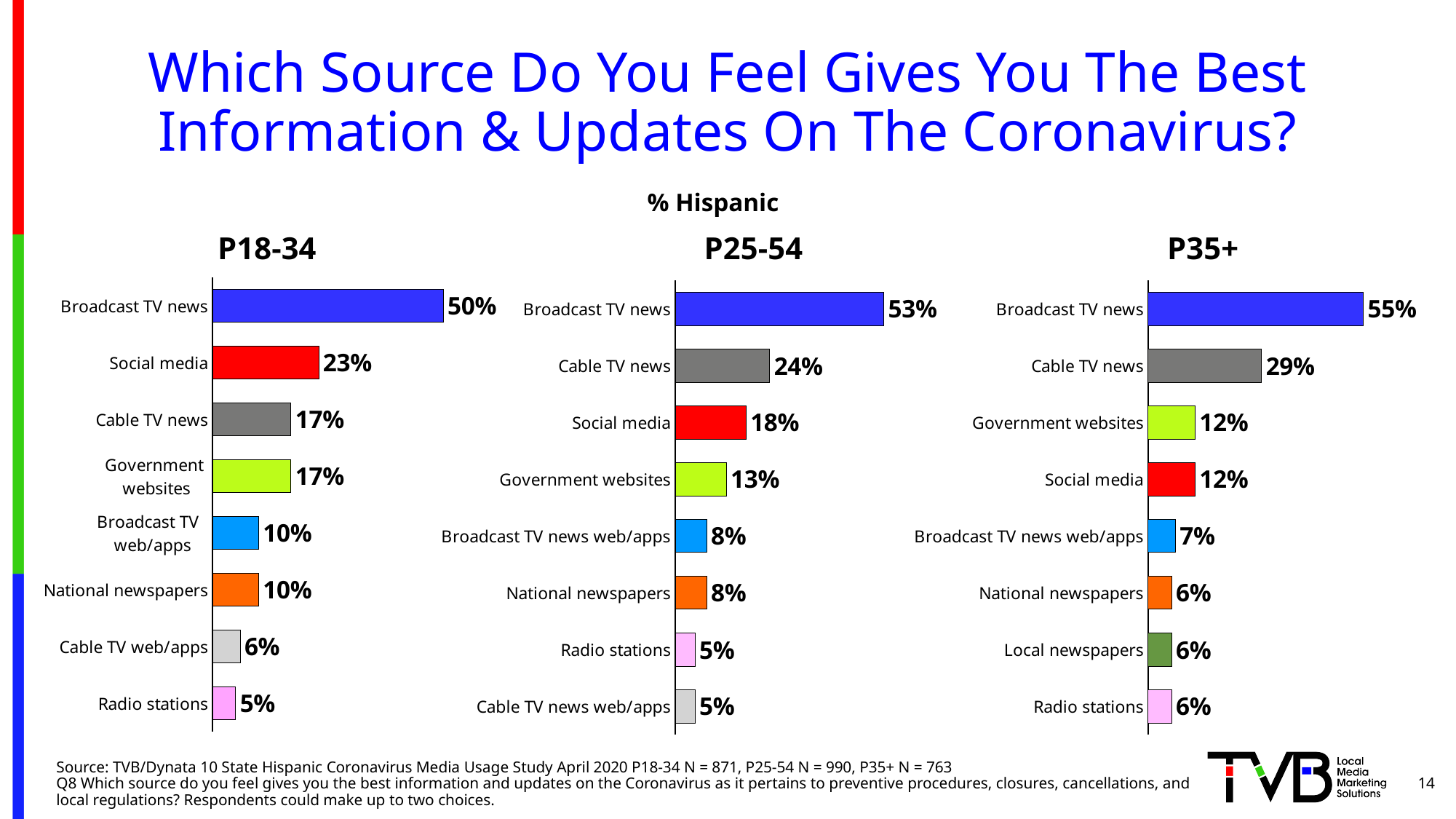
In the P25-54 chart, what is the difference between Broadcast TV news and Cable TV news? 29% How many categories are shown in the P25-54 chart? 8 In the P35+ chart, which category has the highest value? Broadcast TV news What colour is the Broadcast TV news bar in each chart? Blue In the P18-34 chart, what is the value for Broadcast TV news? 50% In the P35+ chart, what is the difference between Cable TV news and Social media? 17% In the P18-34 chart, what is the value for National newspapers? 10% In the P18-34 chart, which category has the lowest value? Radio stations In the P18-34 chart, which is larger: Social media or Cable TV news? Social media In the P25-54 chart, what is the value for Cable TV news? 24% What type of chart is used for the P18-34 data? Bar chart In the P35+ chart, what is the value for Government websites? 12%